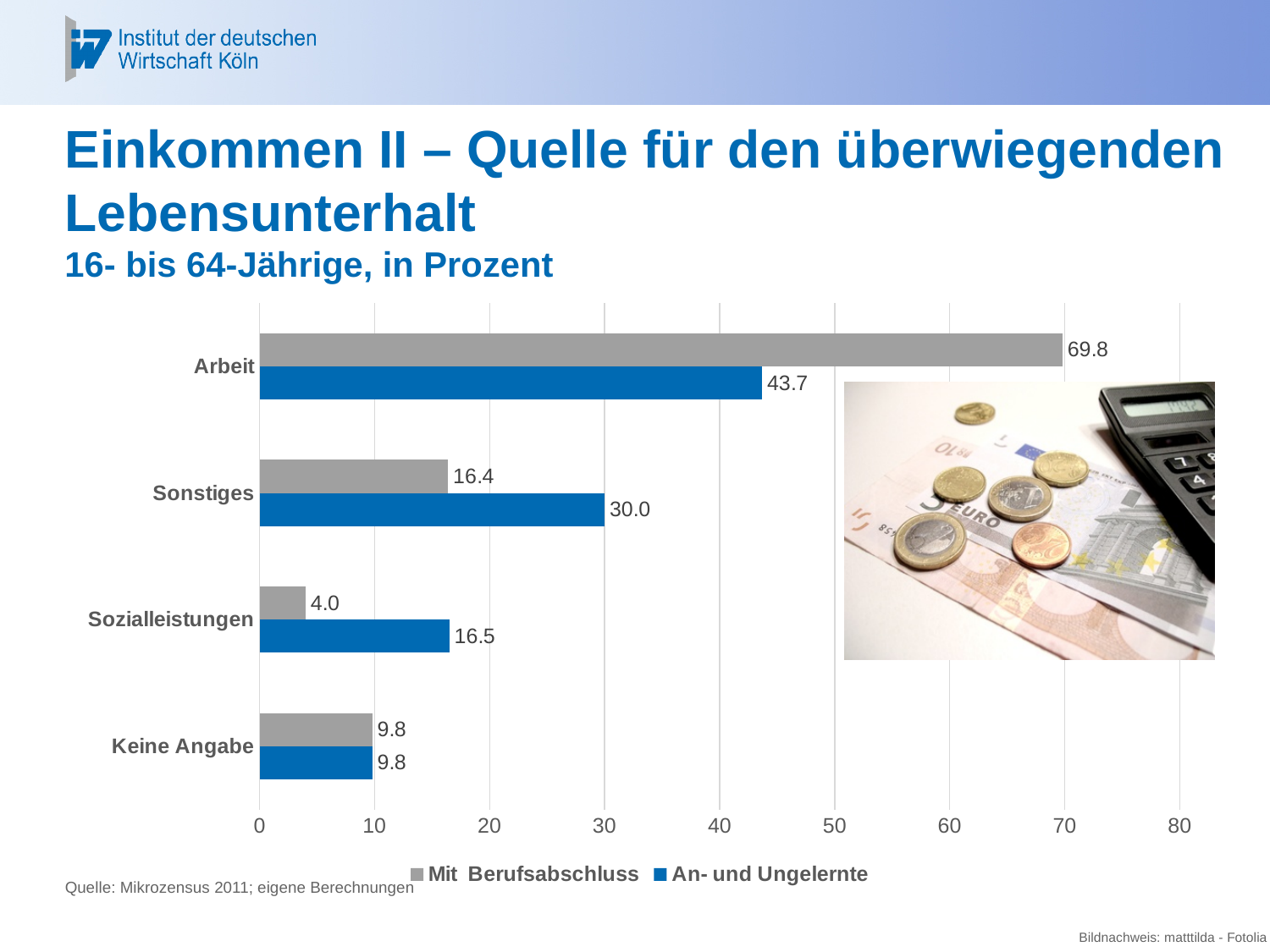
What is the value for Arbeit in the Mit Berufsabschluss series? 69.8 Is the An- und Ungelernte value for Arbeit greater or less than 40? greater Which category has the lowest value in the Mit Berufsabschluss series? Sozialleistungen What kind of chart is shown on the slide? bar chart Which colour represents the An- und Ungelernte series? blue What is the value for Sonstiges in the An- und Ungelernte series? 30.0 How many categories are shown on the chart? 4 How many series does the legend list? 2 For Sozialleistungen, which series has the larger value: Mit Berufsabschluss or An- und Ungelernte? An- und Ungelernte Which category has the highest value in the An- und Ungelernte series? Arbeit What is the value for Sozialleistungen in the Mit Berufsabschluss series? 4.0 What is the difference between the Mit Berufsabschluss and An- und Ungelernte values for Arbeit? 26.1